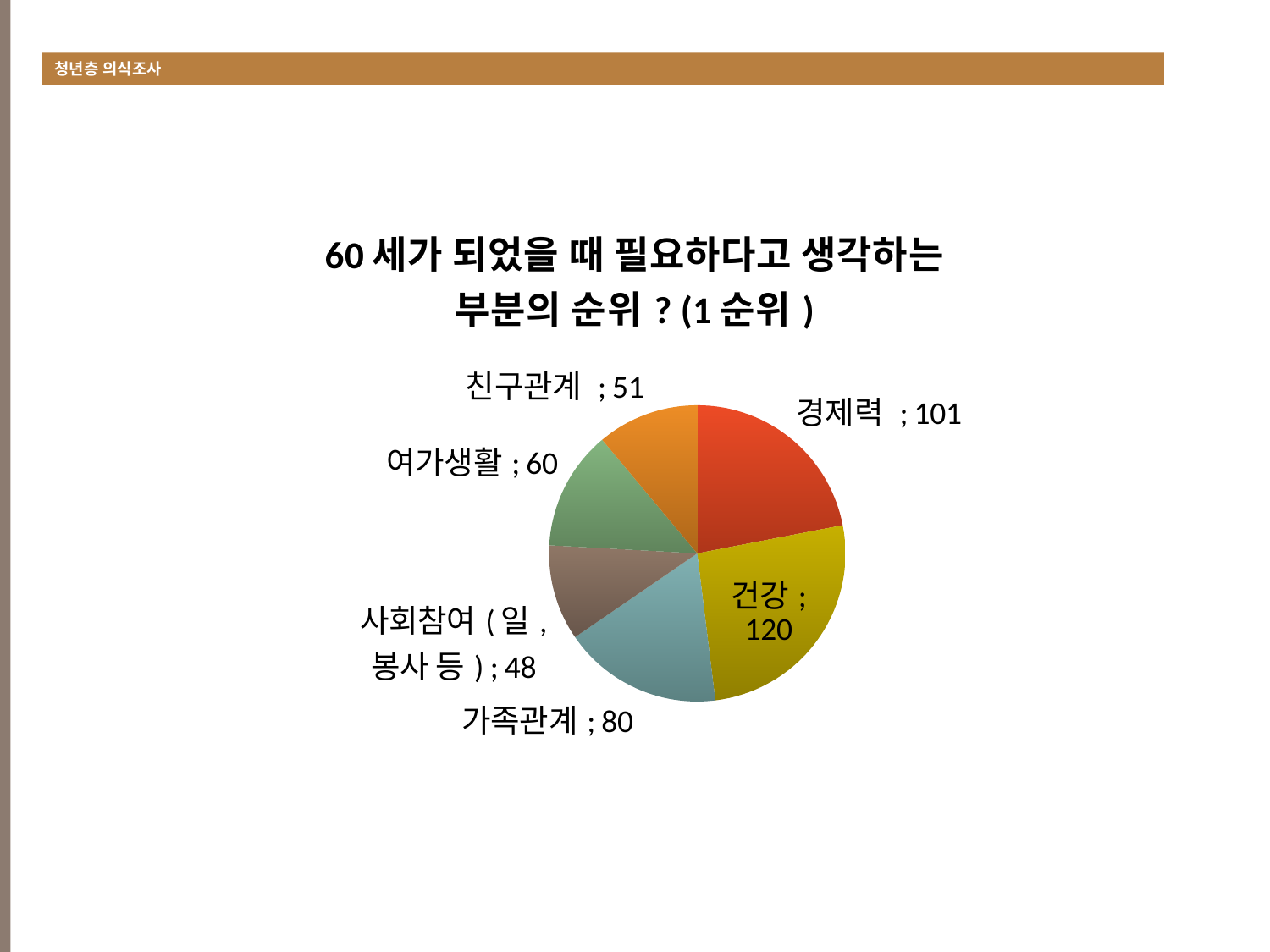
What is the value for 사회참여 (일, 봉사 등) in the pie chart? 48 What is the value for 경제력 in the pie chart? 101 What is the total of all the values shown in the pie chart? 460 What is the difference between the values for 건강 and 경제력? 19 What is the title of the chart? 60 세가 되었을 때 필요하다고 생각하는 부분의 순위 ? (1 순위 ) Which is larger, the value for 여가생활 or the value for 친구관계? 여가생활 What kind of chart is shown on the slide? pie chart How many categories are shown in the pie chart? 6 What is the value for 건강 in the pie chart? 120 Which category has the smallest slice in the pie chart? 사회참여 (일, 봉사 등) What is the value for 가족관계 in the pie chart? 80 Which category has the largest slice in the pie chart? 건강